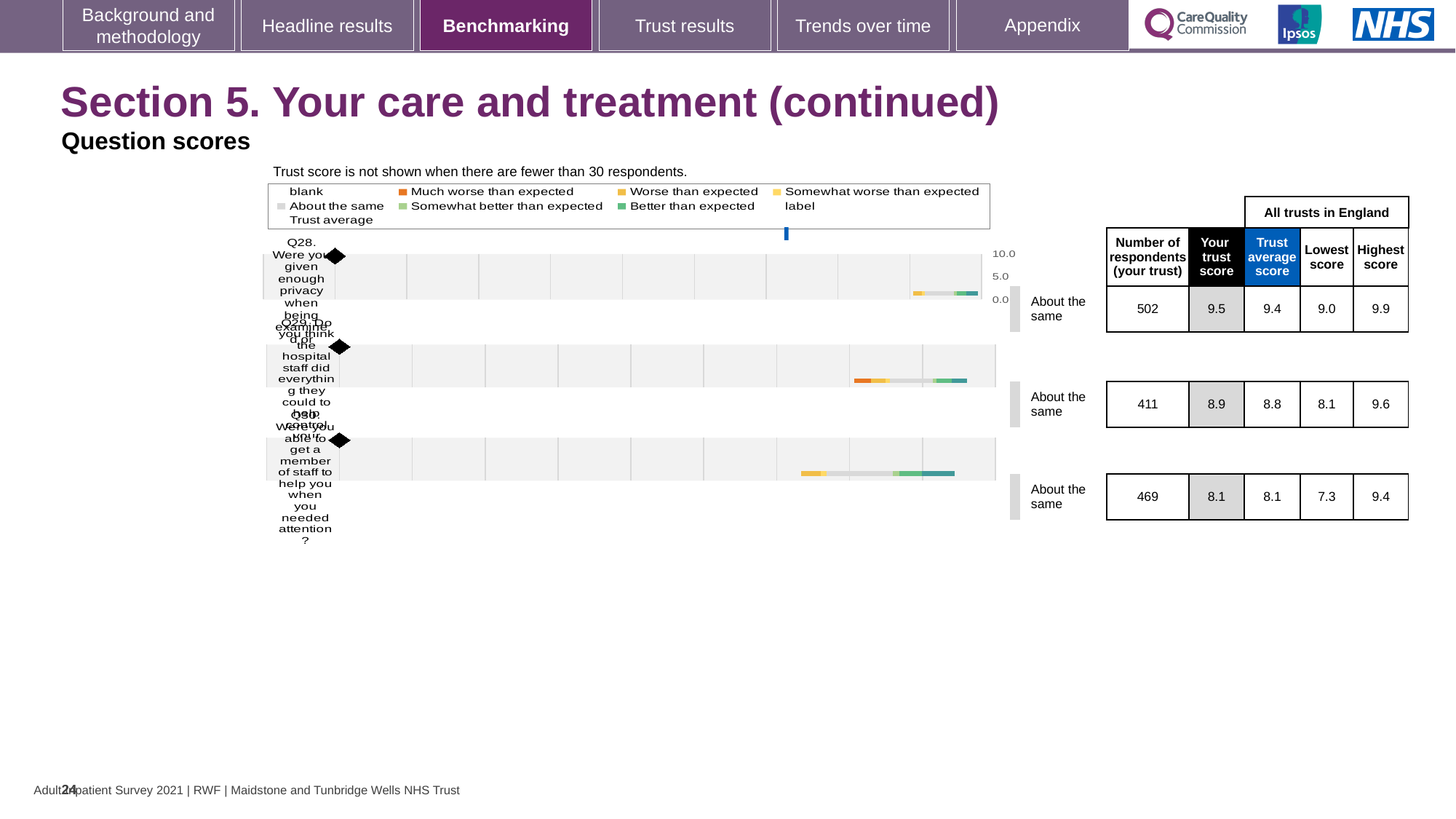
What is the highest score across all trusts in England for Q30? 9.4 What kind of chart is used to show the question scores on this slide? bar chart What is the lowest score across all trusts in England for Q29? 8.1 Which question has the lowest trust score on this slide? Q30 How many questions (Q28, Q29, Q30) are plotted in the benchmarking charts on this slide? 3 Is the trust score for Q28 greater or less than 5.0? greater Which question has the highest trust score on this slide? Q28 What is the difference between the highest score and the lowest score for Q29? 1.5 For Q29, which is larger: the trust score or the trust average score? trust score What benchmark category is shown for Q30? About the same What is the trust score for Q28 (Were you given enough privacy when being examined or treated)? 9.5 How many respondents from the trust answered Q29? 411